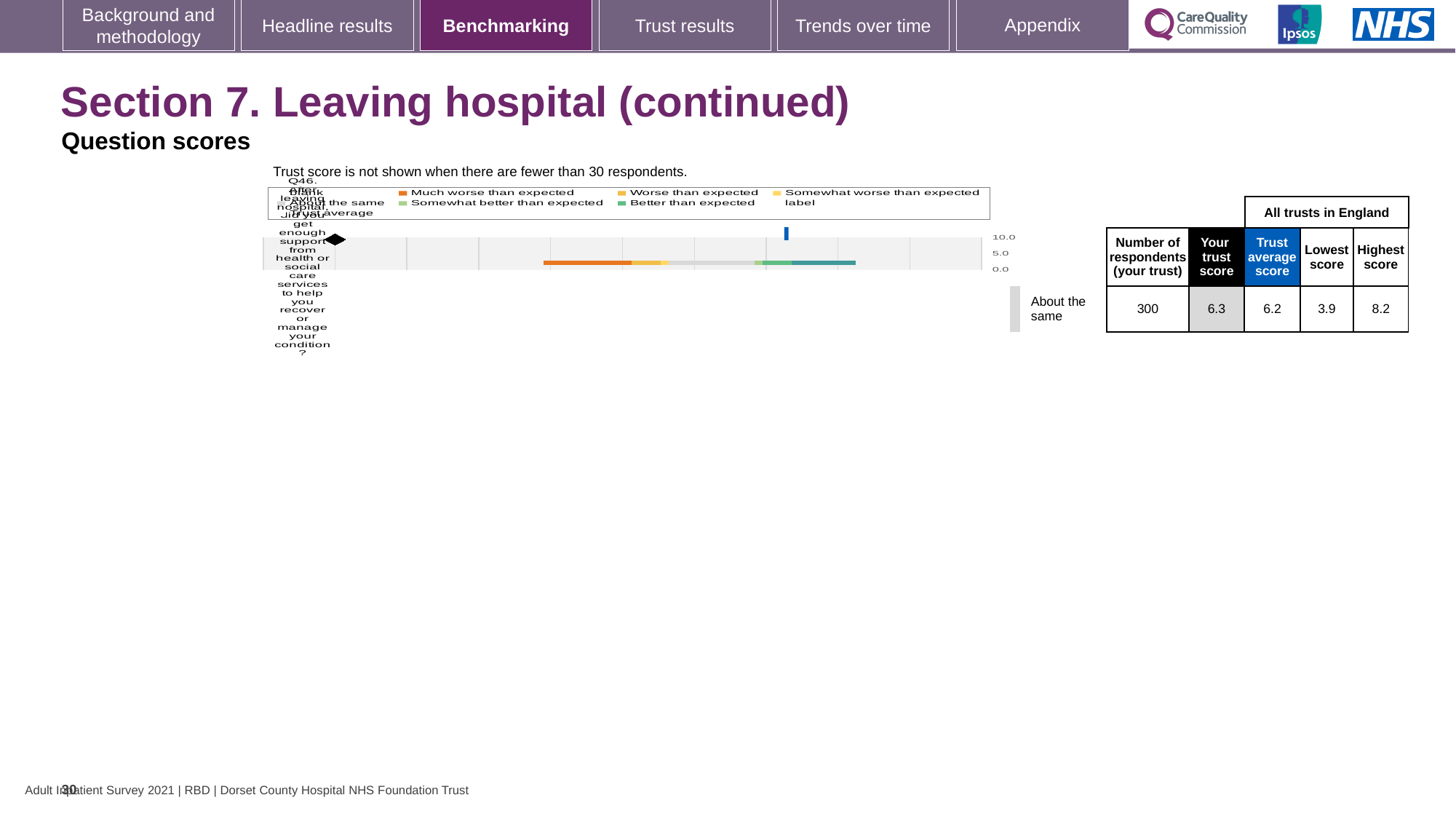
What is the highest score for Q46 among all trusts in England? 8.2 How is the trust's Q46 result categorised relative to expectations? About the same What is the trust average score for Q46 across all trusts in England? 6.2 What is the lowest score for Q46 among all trusts in England? 3.9 What is the maximum value shown on the chart's score axis? 10.0 What is the difference between the trust score and the trust average score for Q46? 0.1 How many respondents from the trust answered Q46? 300 What is the trust score for Q46 shown on the slide? 6.3 What kind of chart is used to show the Q46 benchmarking result? bar chart How many questions are plotted on the chart? 1 What is the difference between the highest score and the lowest score for Q46? 4.3 Which is larger for Q46: the trust score or the trust average score? the trust score